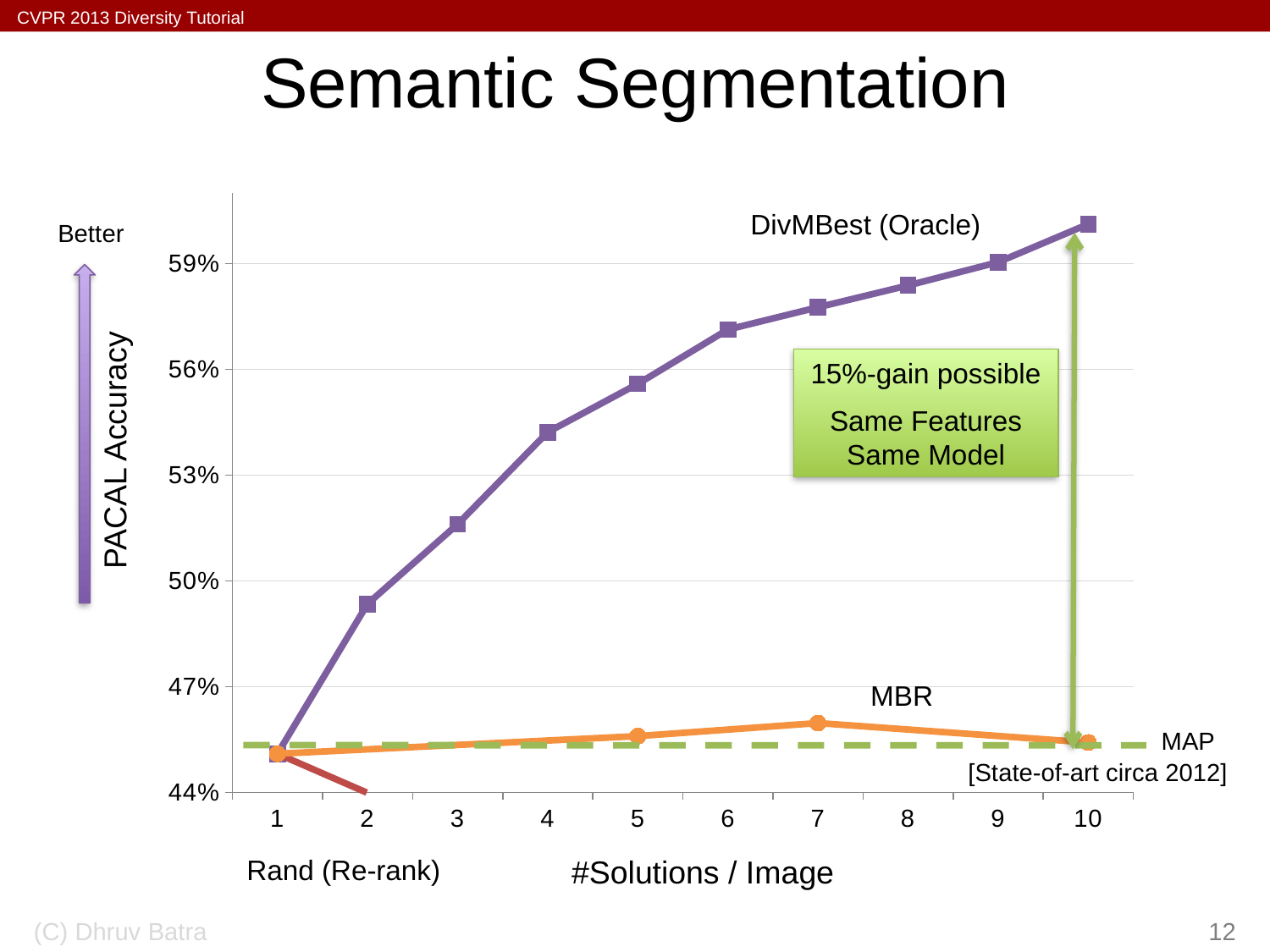
At 10 solutions per image, which is larger: DivMBest (Oracle) or MBR? DivMBest (Oracle) Is the DivMBest (Oracle) value at 10 solutions per image greater or less than 59%? greater Is the MBR value at 7 solutions per image greater or less than 47%? less Is the DivMBest (Oracle) value at 2 solutions per image greater or less than 50%? less What is the label of the x axis? #Solutions / Image What is the label of the y axis? PACAL Accuracy Does the DivMBest (Oracle) series rise or fall as #Solutions / Image increases? rises What kind of chart is shown on the slide? line chart How many series are labelled on the chart? 4 At which number of solutions per image does the DivMBest (Oracle) series reach its highest value? 10 How many x-axis values (#Solutions / Image) are shown on the chart? 10